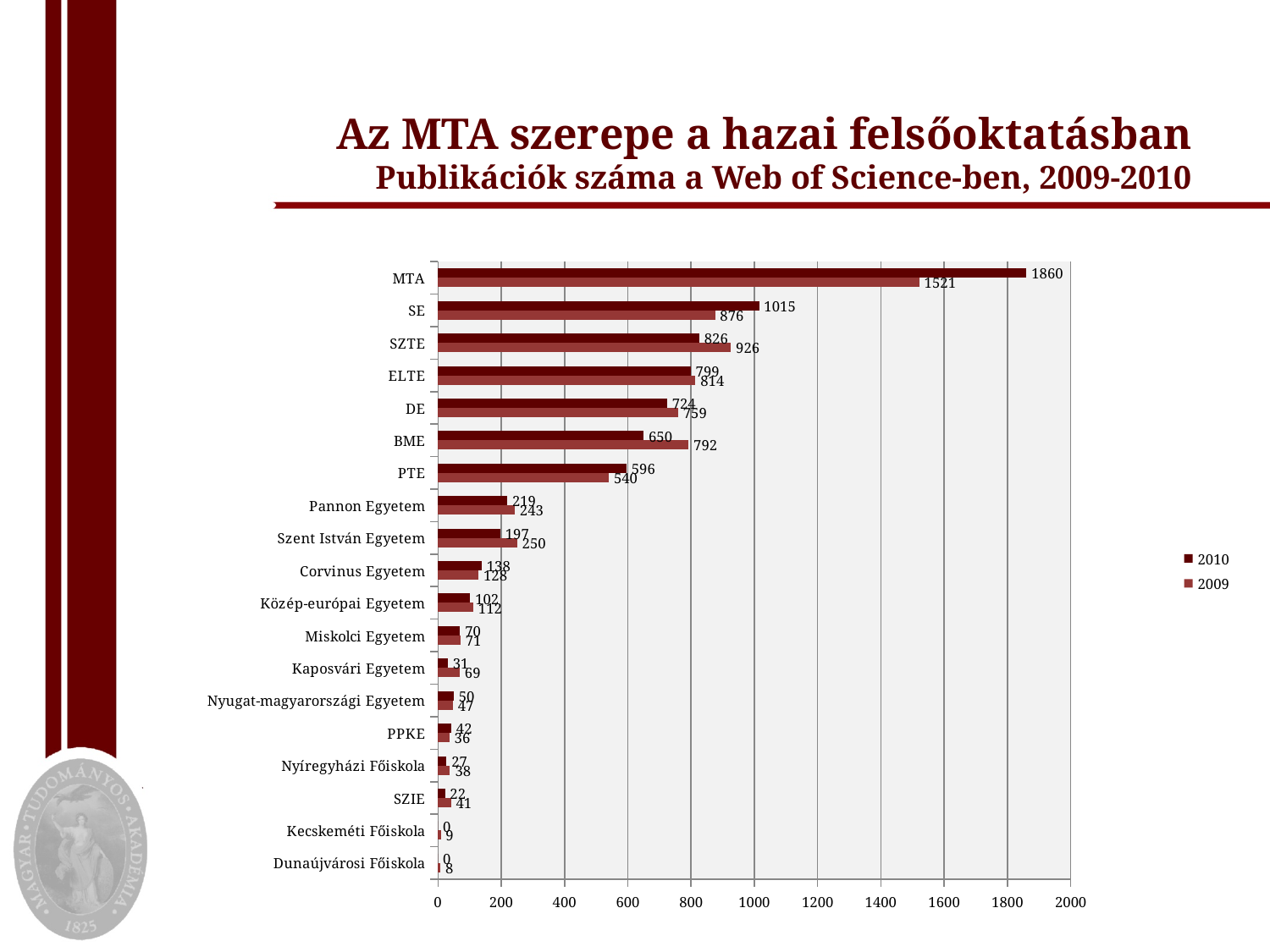
Which series is shown in the darker red colour in the legend? 2010 What is the 2010 value for Kaposvári Egyetem? 31 How many institutions (categories) are shown on the chart? 19 Is the 2010 value for SE greater or less than 1000? greater What is the difference between the 2010 and 2009 values for MTA? 339 What is the 2009 value for BME? 792 Which institution has the lowest 2009 value? Dunaújvárosi Főiskola What type of chart is shown on the slide? bar chart How many series does the legend list? 2 Which institution has the highest 2010 value? MTA What is the 2010 value for MTA? 1860 Which is larger for SZTE, the 2010 value or the 2009 value? 2009